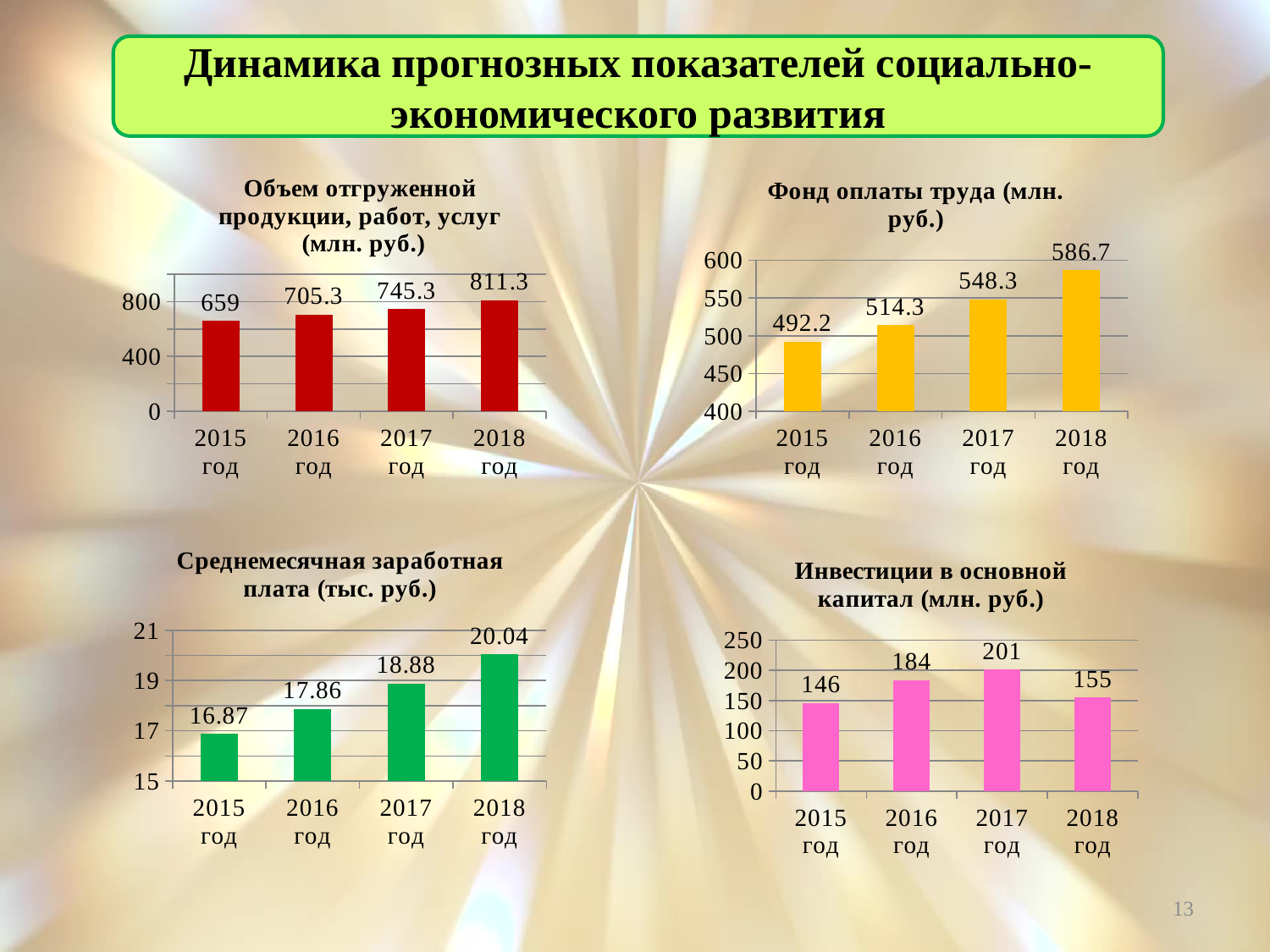
In the chart titled "Объем отгруженной продукции, работ, услуг (млн. руб.)", what is the value for 2017 год? 745.3 How many years are shown in the chart titled "Среднемесячная заработная плата (тыс. руб.)"? 4 In the chart titled "Объем отгруженной продукции, работ, услуг (млн. руб.)", what is the difference between the values for 2018 год and 2015 год? 152.3 In the chart titled "Фонд оплаты труда (млн. руб.)", what is the value for 2015 год? 492.2 In the chart titled "Фонд оплаты труда (млн. руб.)", what is the difference between the values for 2018 год and 2017 год? 38.4 What kind of chart is the chart titled "Фонд оплаты труда (млн. руб.)"? Bar chart In the chart titled "Инвестиции в основной капитал (млн. руб.)", which year has the highest value? 2017 год In the chart titled "Инвестиции в основной капитал (млн. руб.)", which is larger, the value for 2016 год or 2018 год? 2016 год In the chart titled "Среднемесячная заработная плата (тыс. руб.)", what is the value for 2018 год? 20.04 In the chart titled "Среднемесячная заработная плата (тыс. руб.)", do the values rise or fall from 2015 год to 2018 год? Rise In the chart titled "Инвестиции в основной капитал (млн. руб.)", which year has the lowest value? 2015 год What colour are the bars in the chart titled "Инвестиции в основной капитал (млн. руб.)"? Pink